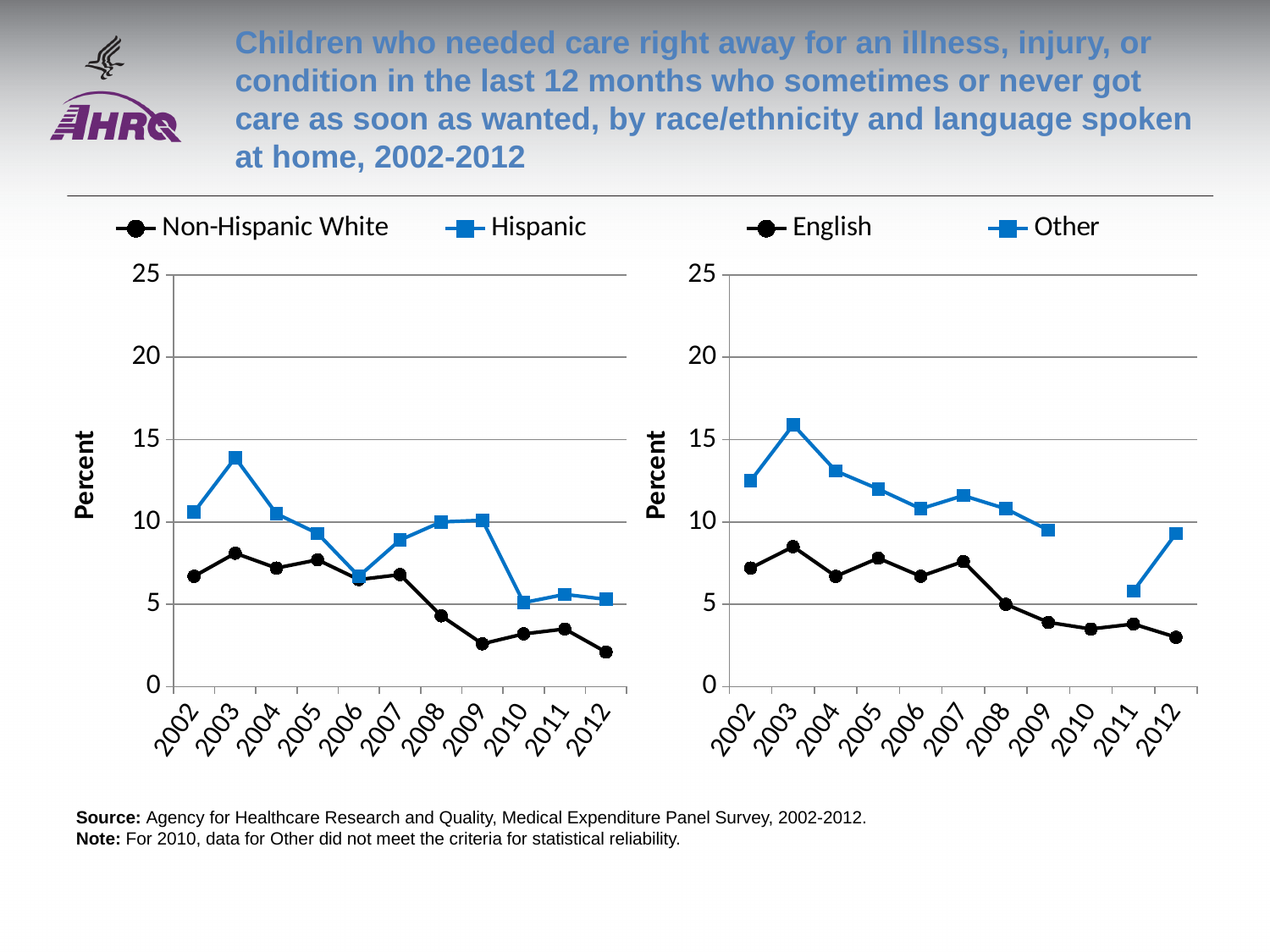
In the right chart, which is larger in 2003, English or Other? Other In the left chart, is the Non-Hispanic White value for 2012 greater or less than 5? less In the left chart, is the Hispanic value for 2003 greater or less than 10? greater In the right chart, is the Other value for 2003 greater or less than 15? greater In the left chart, how many years are shown on the x axis? 11 What kind of chart is the left chart (Non-Hispanic White and Hispanic)? line chart In the left chart, in which year is the Hispanic value highest? 2003 In the left chart, in which year is the Non-Hispanic White value lowest? 2012 In the right chart, does the English series generally rise or fall from 2002 to 2012? fall In the right chart, in which year is the Other value highest? 2003 In the right chart, which year has no data point for the Other series? 2010 How many series does the legend of the right chart list? 2